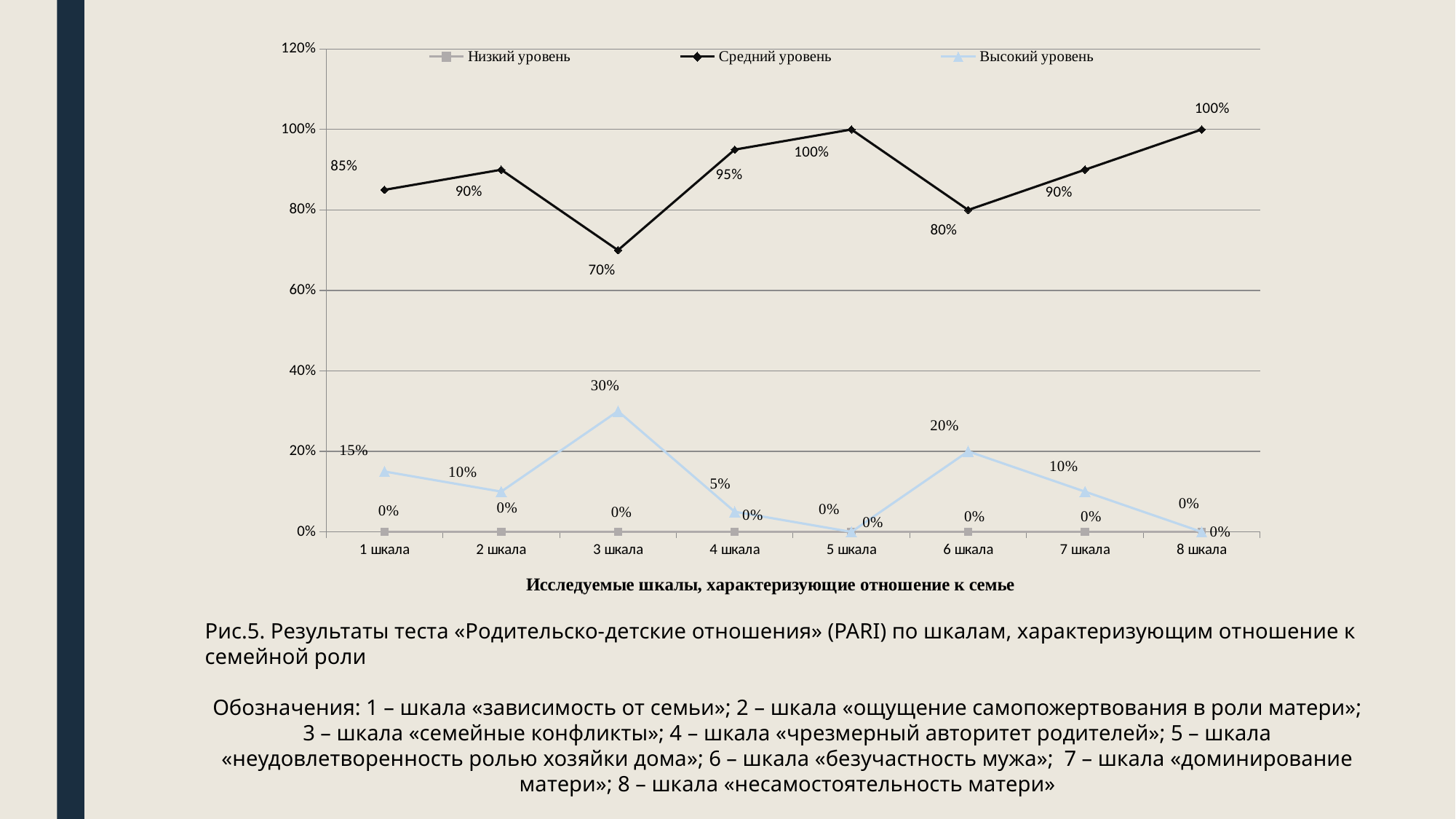
What is the value of Средний уровень for 3 шкала? 70% For which category is Средний уровень the lowest? 3 шкала What is the x-axis title of the chart? Исследуемые шкалы, характеризующие отношение к семье How many series does the legend list? 3 Which is larger: Высокий уровень for 1 шкала or for 2 шкала? 1 шкала How many categories (шкалы) are shown on the x axis? 8 What type of chart is shown on the slide? Line chart For which category is Высокий уровень the highest? 3 шкала Is the value of Средний уровень for 1 шкала greater or less than 80%? greater What is the value of Низкий уровень for 4 шкала? 0% What is the value of Высокий уровень for 6 шкала? 20% What is the difference between Средний уровень for 5 шкала and for 6 шкала? 20%